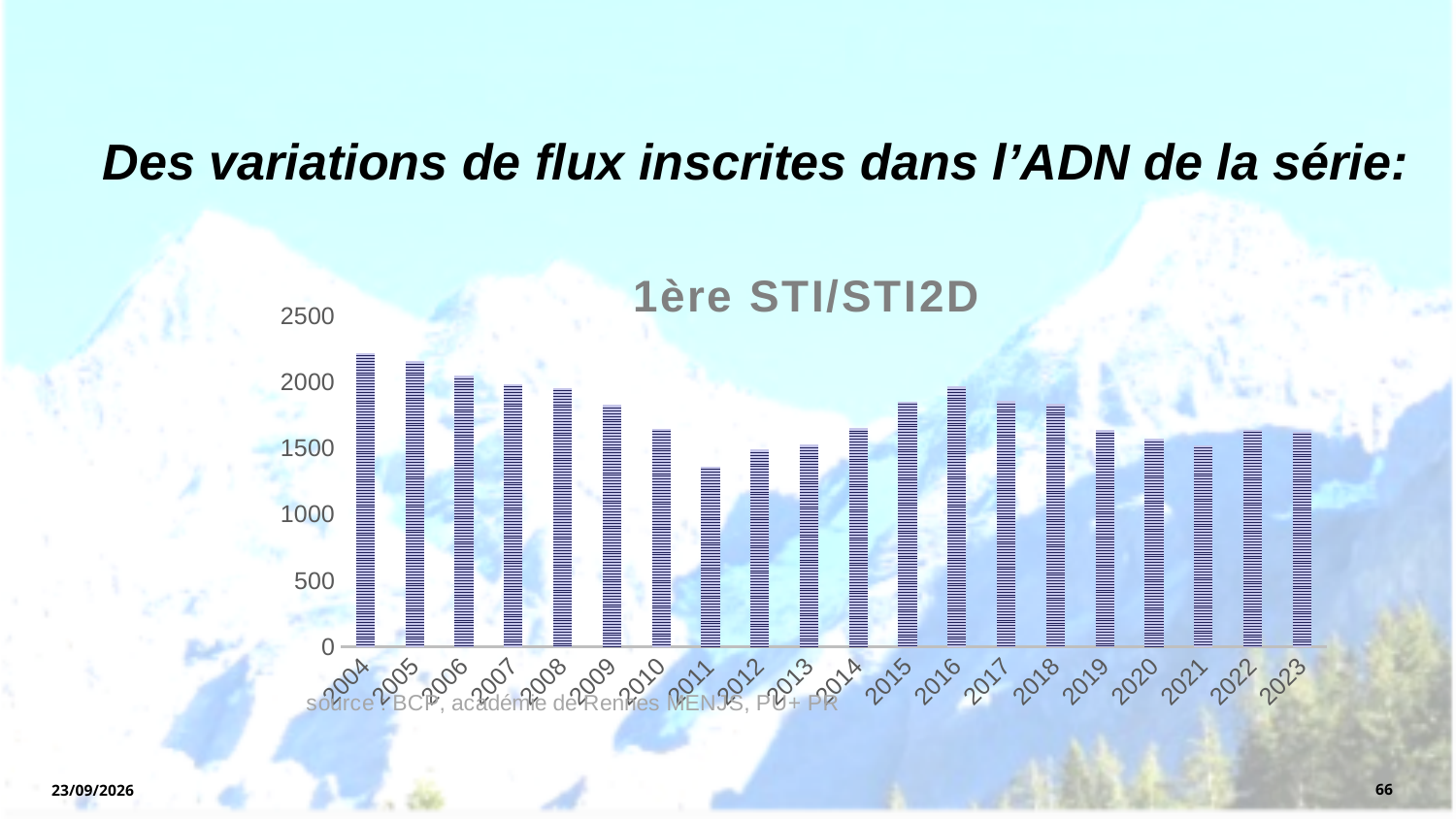
Is the value for 2009 greater or less than 2000? less Which year has the lowest bar in the chart? 2011 Which is larger, the value for 2005 or the value for 2010? 2005 Is the value for 2004 greater or less than 2000? greater Is the value for 2015 greater or less than 1500? greater Which is larger, the value for 2016 or the value for 2012? 2016 What is the title of the chart? 1ère STI/STI2D What kind of chart is shown on the slide? bar chart How many years are plotted on the x axis of the chart? 20 Which year has the highest bar in the chart? 2004 Do the values rise or fall from 2004 to 2011? fall